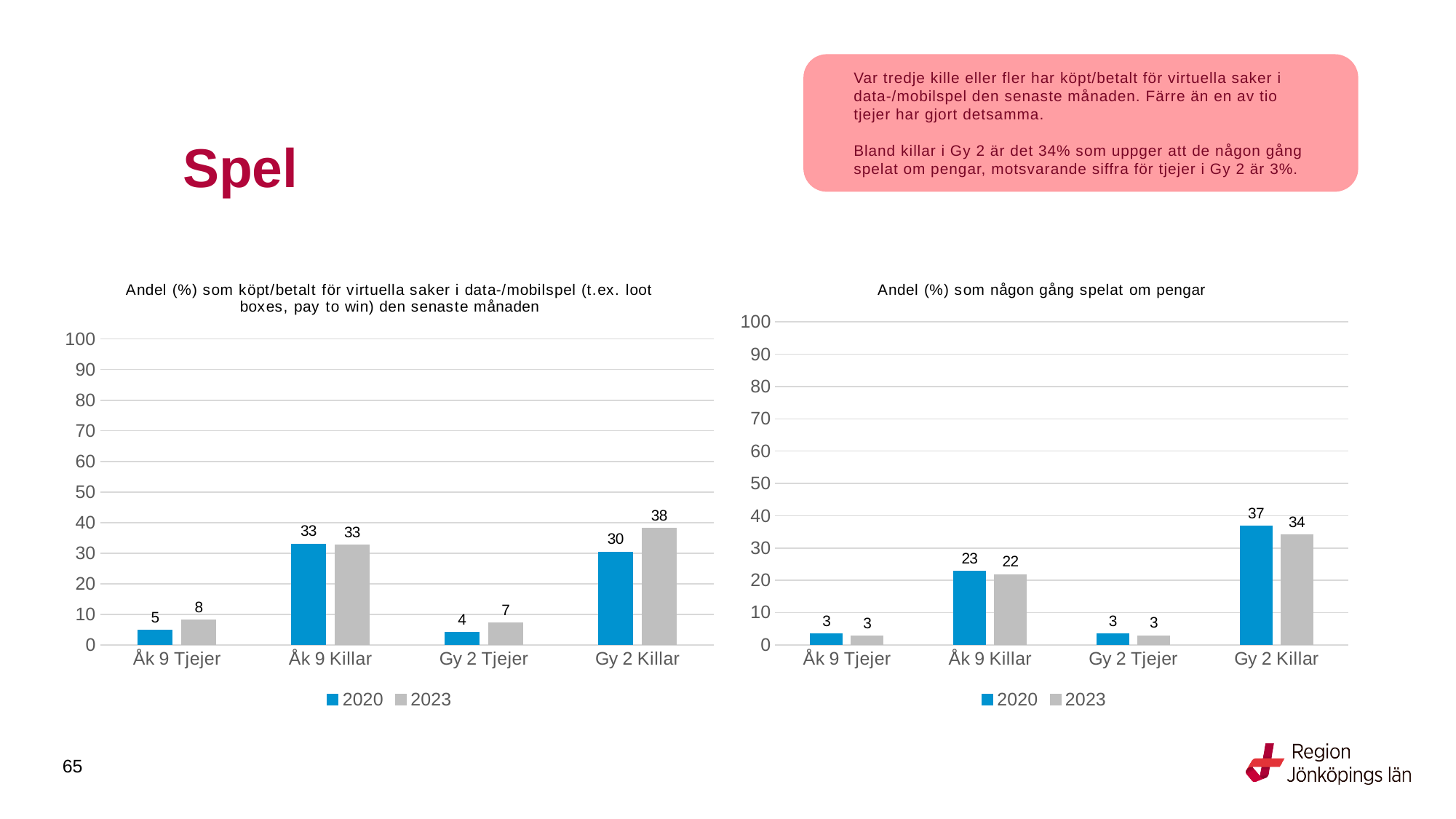
In the left chart (virtuella saker i data-/mobilspel), which category has the highest 2023 value? Gy 2 Killar In the right chart (spelat om pengar), what is the 2023 value for Åk 9 Killar? 22 In the left chart (virtuella saker i data-/mobilspel), what is the 2020 value for Åk 9 Tjejer? 5 In the right chart (spelat om pengar), what is the difference between the 2020 and 2023 values for Gy 2 Killar? 3 In the left chart (virtuella saker i data-/mobilspel), which category has the lowest 2020 value? Gy 2 Tjejer How many series does the legend of the left chart (virtuella saker i data-/mobilspel) list? 2 In the left chart (virtuella saker i data-/mobilspel), what is the difference between the 2023 values for Gy 2 Killar and Gy 2 Tjejer? 31 How many categories are shown on the x axis of the right chart (spelat om pengar)? 4 In the right chart (spelat om pengar), what is the 2020 value for Gy 2 Killar? 37 In the left chart (virtuella saker i data-/mobilspel), what is the 2023 value for Gy 2 Killar? 38 What type of chart is the right chart (spelat om pengar)? Bar chart In the left chart (virtuella saker i data-/mobilspel), which is larger for Gy 2 Killar: the 2020 value or the 2023 value? 2023